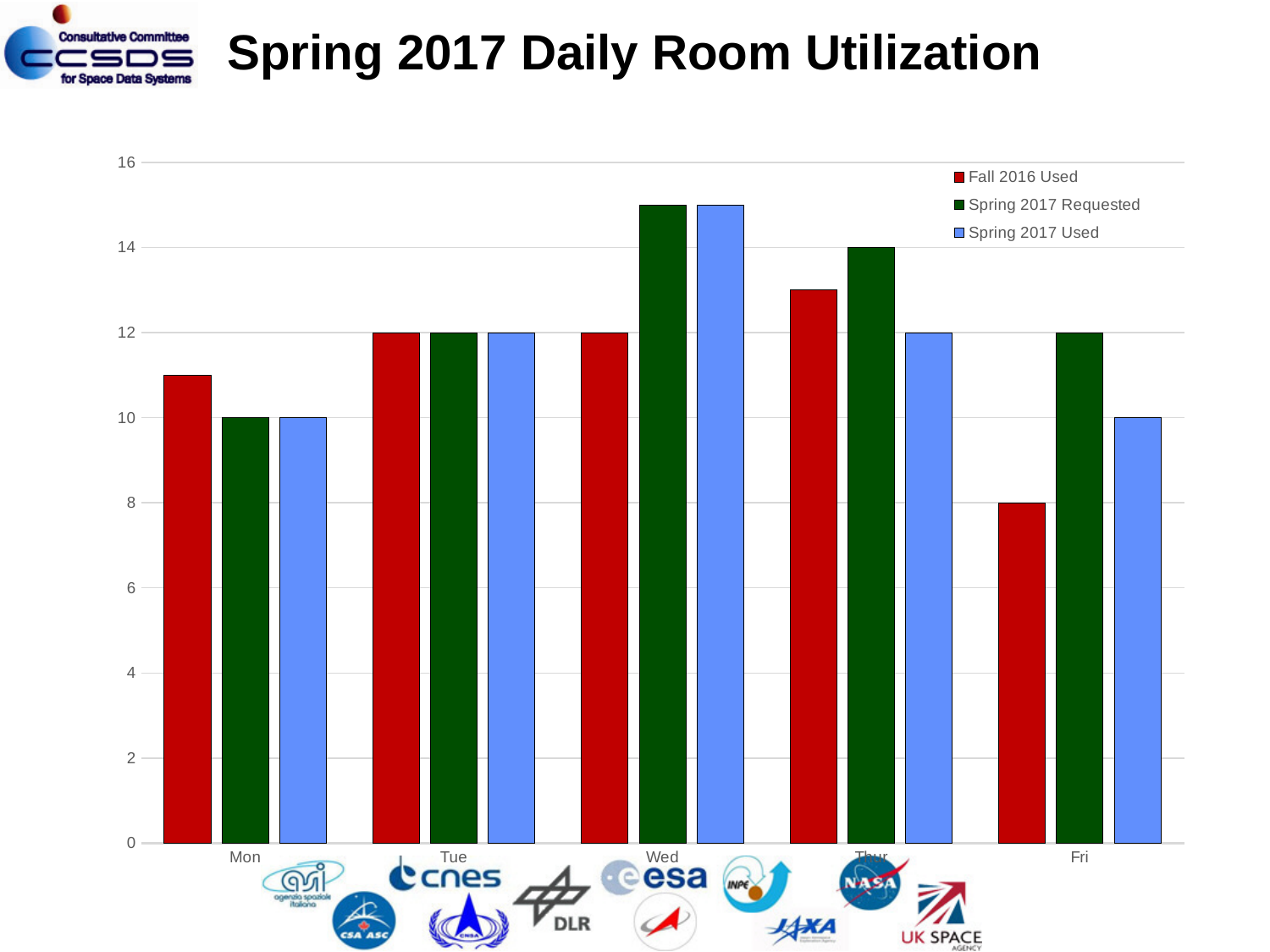
How many days are shown on the x axis? 5 Which day has the highest Spring 2017 Used value? Wed What is the Spring 2017 Requested value for Thur? 14 What kind of chart is shown on the slide? bar chart Is the Fall 2016 Used value for Mon greater or less than 10? greater Which day has the lowest Fall 2016 Used value? Fri On Thur, which is larger: Spring 2017 Requested or Spring 2017 Used? Spring 2017 Requested How many series does the legend list? 3 What is the Fall 2016 Used value for Fri? 8 On Fri, what is the difference between Spring 2017 Requested and Spring 2017 Used? 2 What is the Spring 2017 Used value for Mon? 10 Is the Spring 2017 Requested value for Wed greater or less than 14? greater